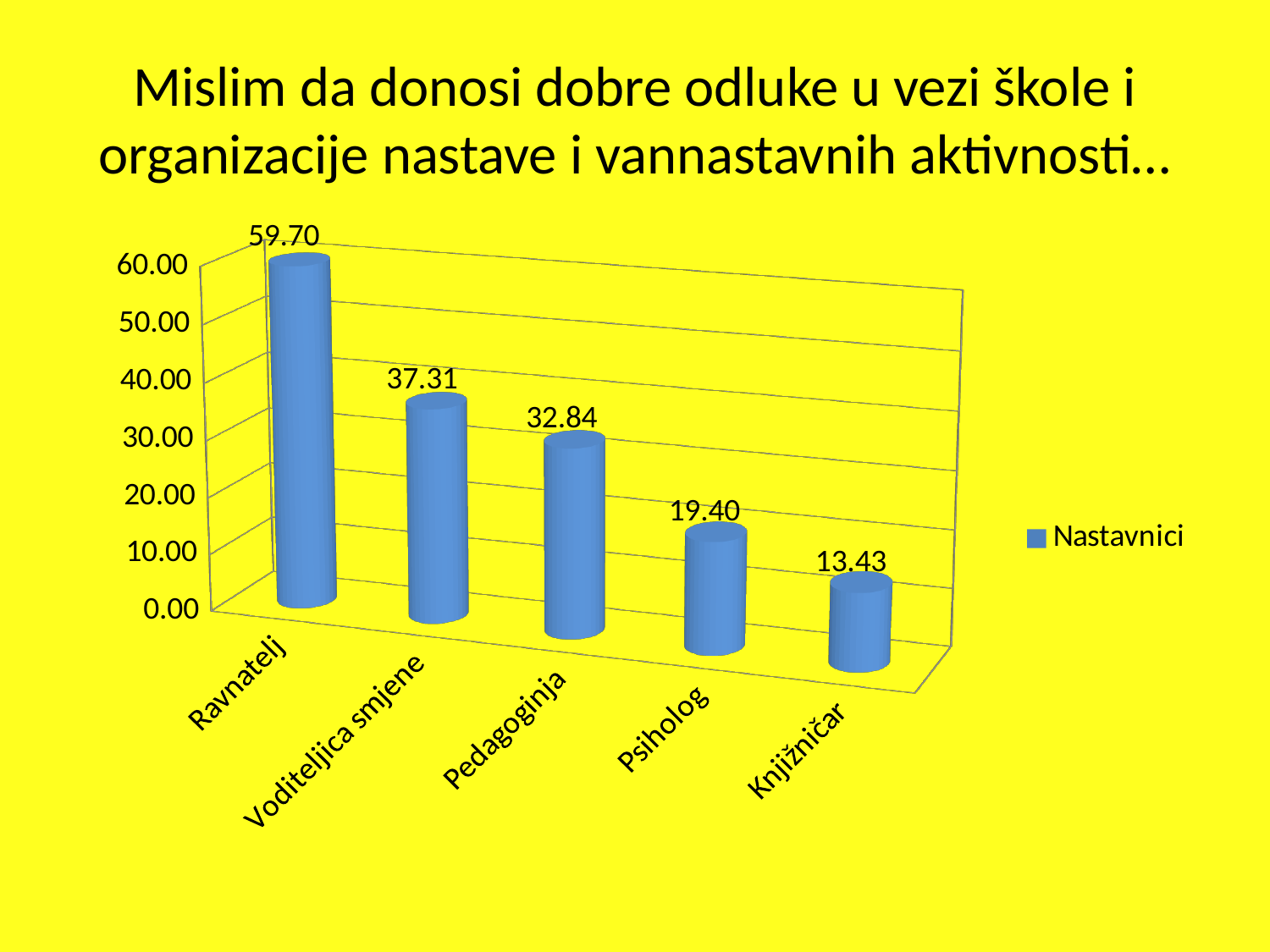
What is the value for Ravnatelj? 59.70 What is the value for Pedagoginja? 32.84 Which category has the lowest value? Knjižničar What series name does the legend show? Nastavnici How many categories are shown on the x axis? 5 What kind of chart is shown on the slide? Bar chart What is the value for Psiholog? 19.40 Which is larger, the value for Pedagoginja or the value for Psiholog? Pedagoginja Which category has the highest value? Ravnatelj What is the difference between the values for Ravnatelj and Voditeljica smjene? 22.39 What is the value for Knjižničar? 13.43 What is the value for Voditeljica smjene? 37.31